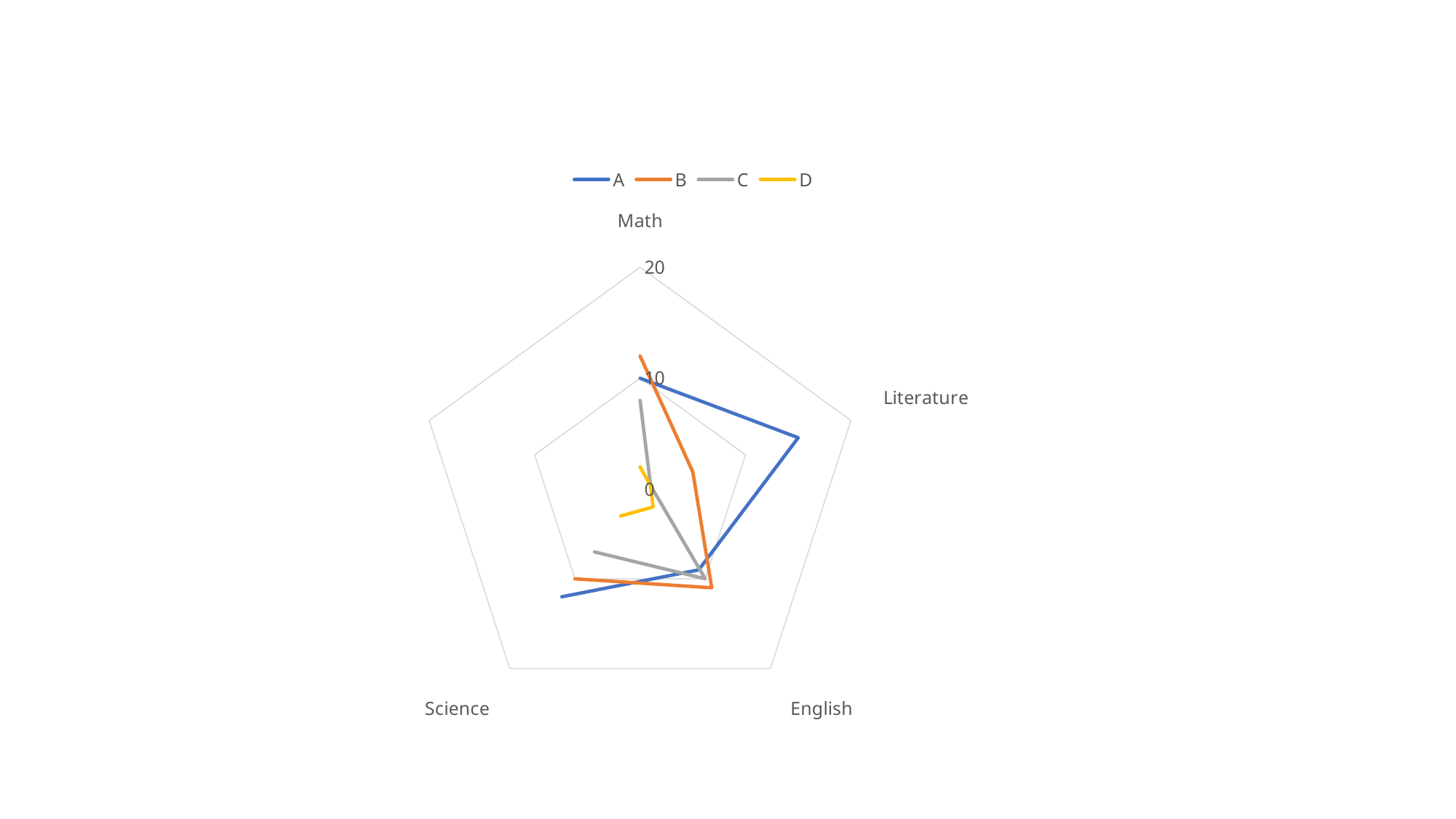
Which series has the highest value for Literature? A For Literature, which series has the larger value, A or B? A How many series does the legend list? 4 What kind of chart is shown on the slide? radar chart For Math, which series has the larger value, A or B? B Is the value of series D for Math greater or less than 10? less What is the highest tick value shown on the chart's axis? 20 Is the value of series B for Math greater or less than 10? greater Is the value of series C for Literature greater or less than 10? less Which series has the lowest value for Math? D